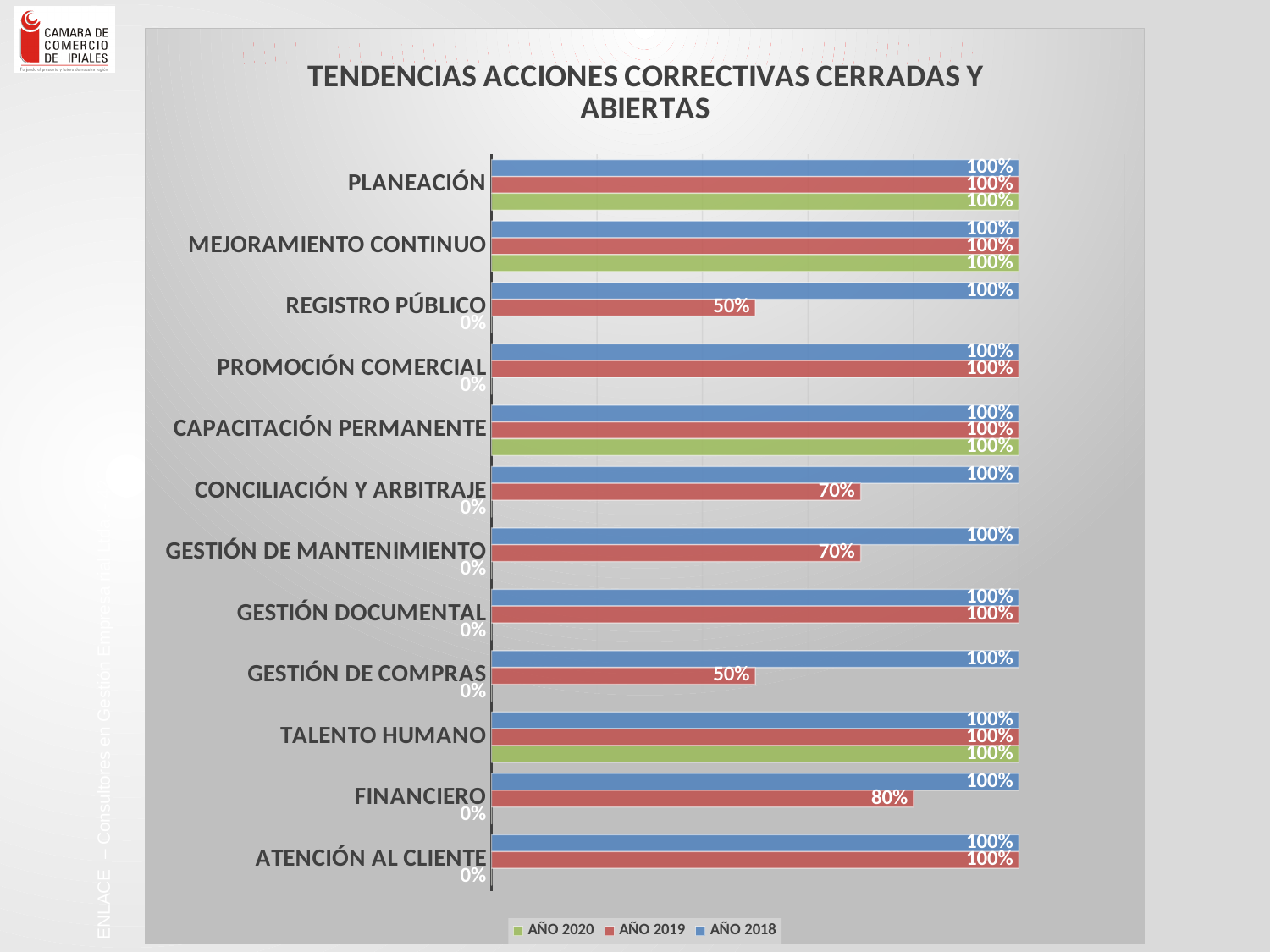
Which series is shown in green in the legend? AÑO 2020 What type of chart is shown on the slide? Bar chart What is the difference between the AÑO 2018 and AÑO 2019 values for GESTIÓN DE MANTENIMIENTO? 30% What is the value for REGISTRO PÚBLICO in AÑO 2019? 50% What is the value for CONCILIACIÓN Y ARBITRAJE in AÑO 2019? 70% What is the title of the chart? TENDENCIAS ACCIONES CORRECTIVAS CERRADAS Y ABIERTAS What is the value for GESTIÓN DE COMPRAS in AÑO 2020? 0% What is the value for TALENTO HUMANO in AÑO 2020? 100% How many series does the legend list? 3 What is the value for FINANCIERO in AÑO 2019? 80% Which is larger for FINANCIERO: the AÑO 2018 value or the AÑO 2019 value? AÑO 2018 How many categories are shown on the chart? 12